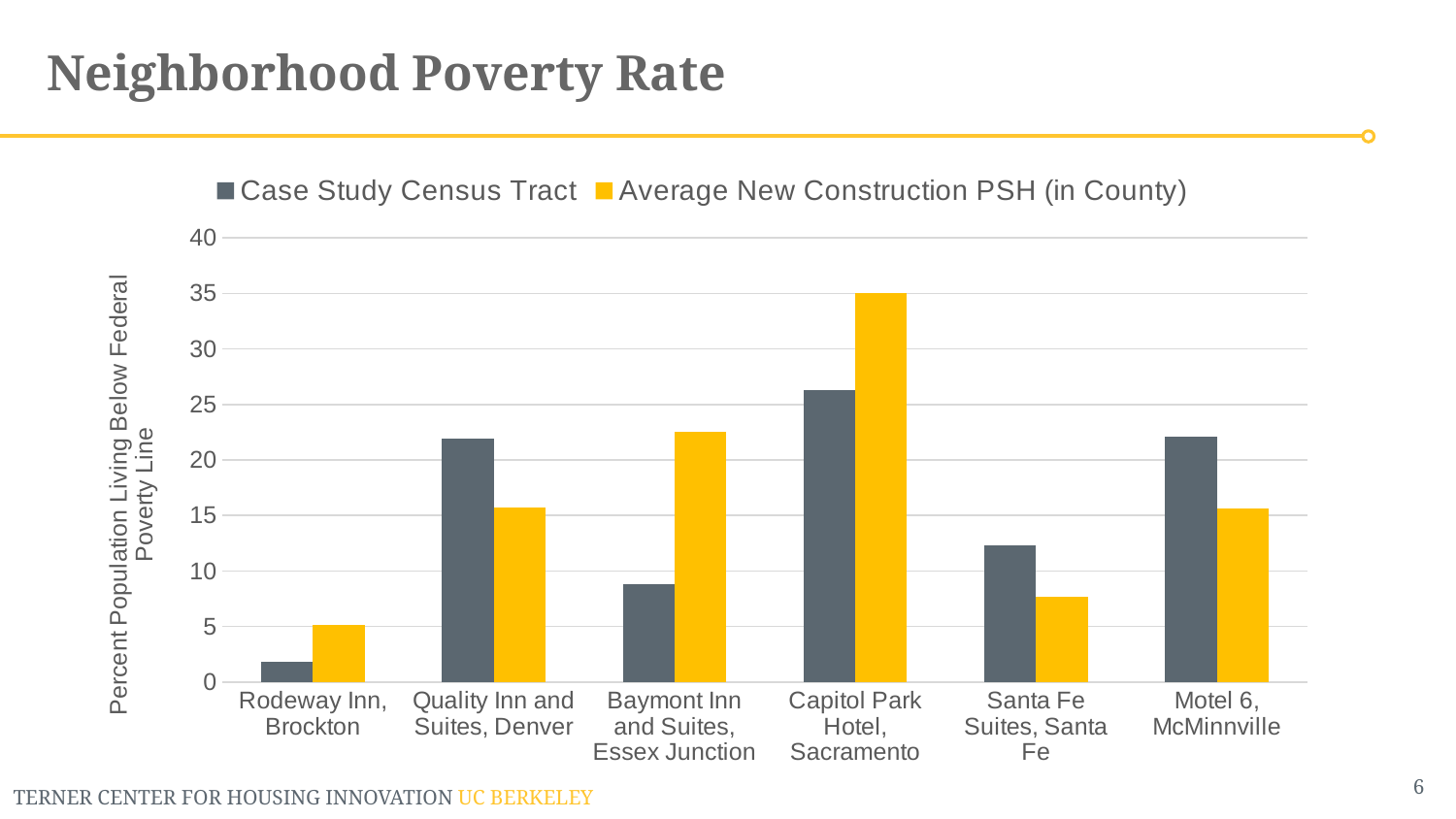
Is the Average New Construction PSH (in County) value for Santa Fe Suites, Santa Fe greater or less than 10? less Is the Case Study Census Tract value for Baymont Inn and Suites, Essex Junction greater or less than 10? less Which category has the lowest Average New Construction PSH (in County) value? Rodeway Inn, Brockton Is the Case Study Census Tract value for Capitol Park Hotel, Sacramento greater or less than 25? greater For Baymont Inn and Suites, Essex Junction, which series has the larger value: Case Study Census Tract or Average New Construction PSH (in County)? Average New Construction PSH (in County) What is the label on the vertical axis of the chart? Percent Population Living Below Federal Poverty Line For Quality Inn and Suites, Denver, which series has the larger value: Case Study Census Tract or Average New Construction PSH (in County)? Case Study Census Tract What kind of chart is shown on the slide? bar chart How many series does the legend list? 2 Which category has the lowest Case Study Census Tract value? Rodeway Inn, Brockton How many hotel categories are shown on the x axis? 6 Which category has the highest Average New Construction PSH (in County) value? Capitol Park Hotel, Sacramento